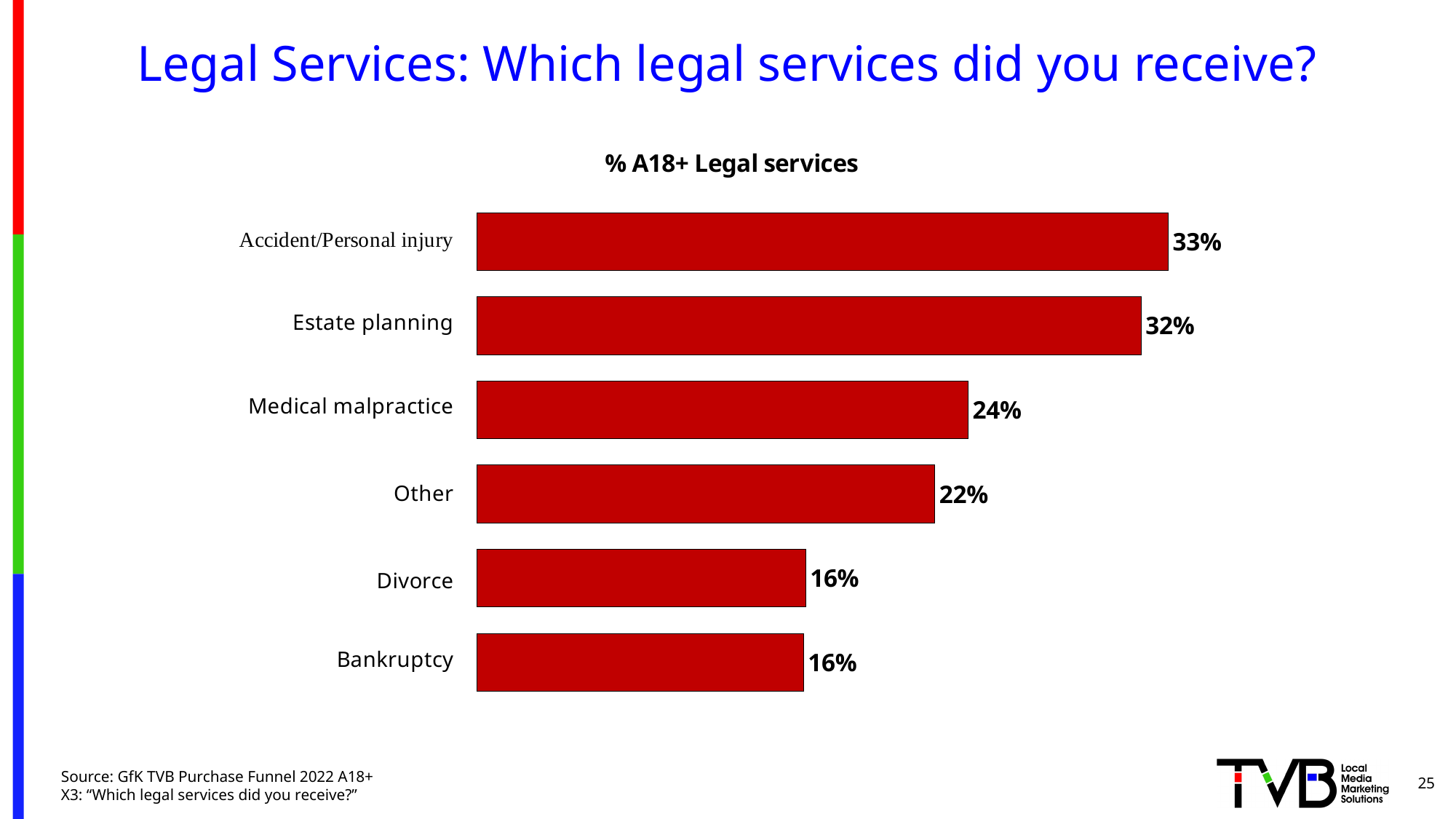
What is the value shown for Divorce? 16% What is the value shown for Estate planning? 32% What kind of chart is shown on the slide? Bar chart What is the title of the chart? % A18+ Legal services What is the value shown for Medical malpractice? 24% What percentage of A18+ received Accident/Personal injury legal services? 33% Which is larger, the value for Estate planning or the value for Medical malpractice? Estate planning Which legal service has the highest percentage? Accident/Personal injury What is the difference in percentage points between Accident/Personal injury and Bankruptcy? 17 How many legal service categories are shown in the chart? 6 What colour are the bars in the chart? Red What is the difference in percentage points between Medical malpractice and Other? 2